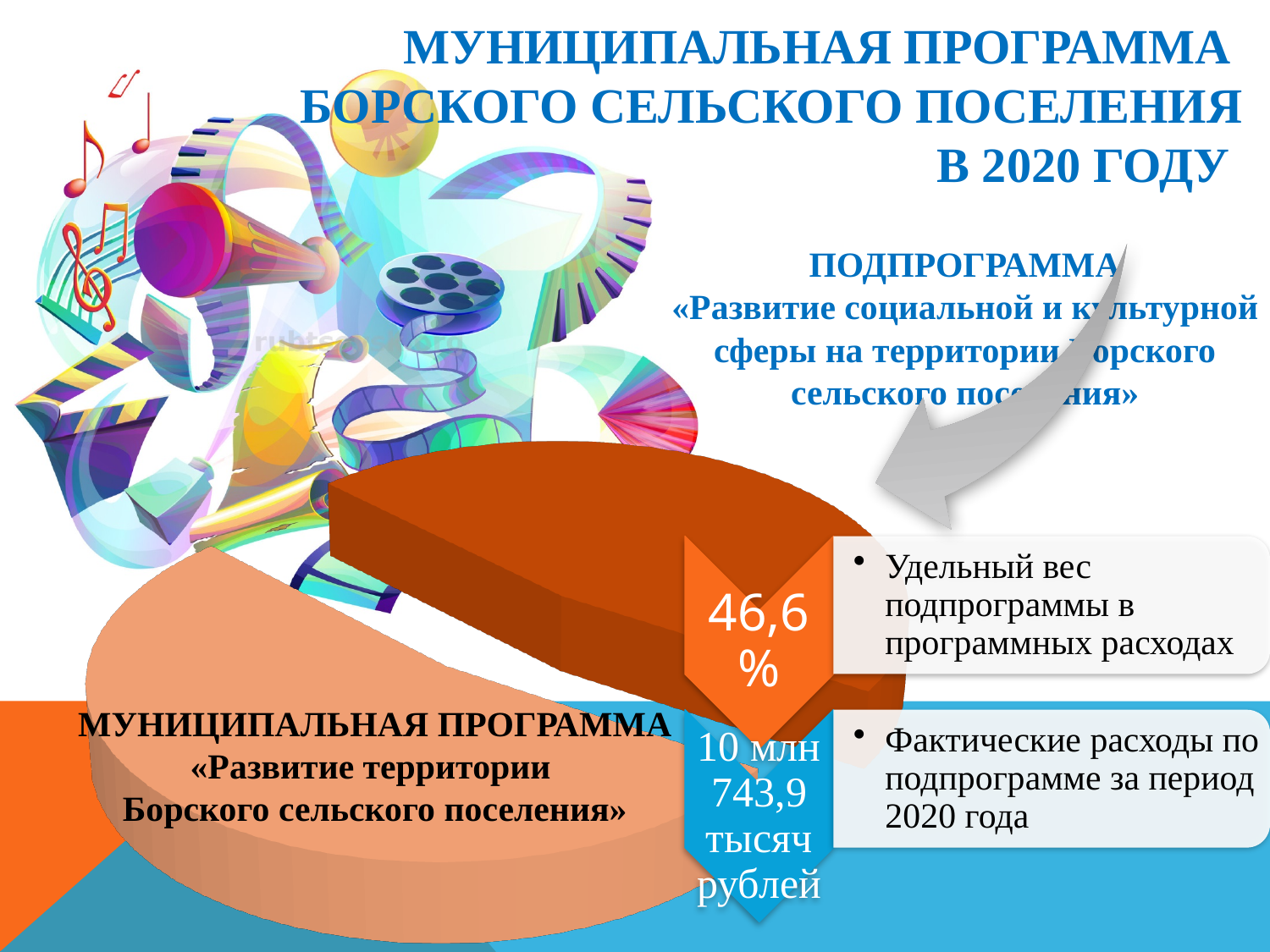
What is the удельный вес (share) of the subprogram in the program expenses, as labelled on the chart? 46,6% What share of the pie does the subprogram «Развитие социальной и культурной сферы на территории Борского сельского поселения» represent? 46,6% What kind of chart is shown on the slide? pie chart Which slice is larger: the dark orange subprogram slice or the light salmon slice of the municipal program «Развитие территории Борского сельского поселения»? the light salmon slice of the municipal program Which municipal program does the pie chart as a whole represent? «Развитие территории Борского сельского поселения» What colour is the exploded slice representing the subprogram? dark orange Is the share of the subprogram in the pie chart greater or less than 50%? less How many slices does the pie chart have? 2 What are the actual expenses for the subprogram for 2020, as shown next to the chart? 10 млн 743,9 тысяч рублей